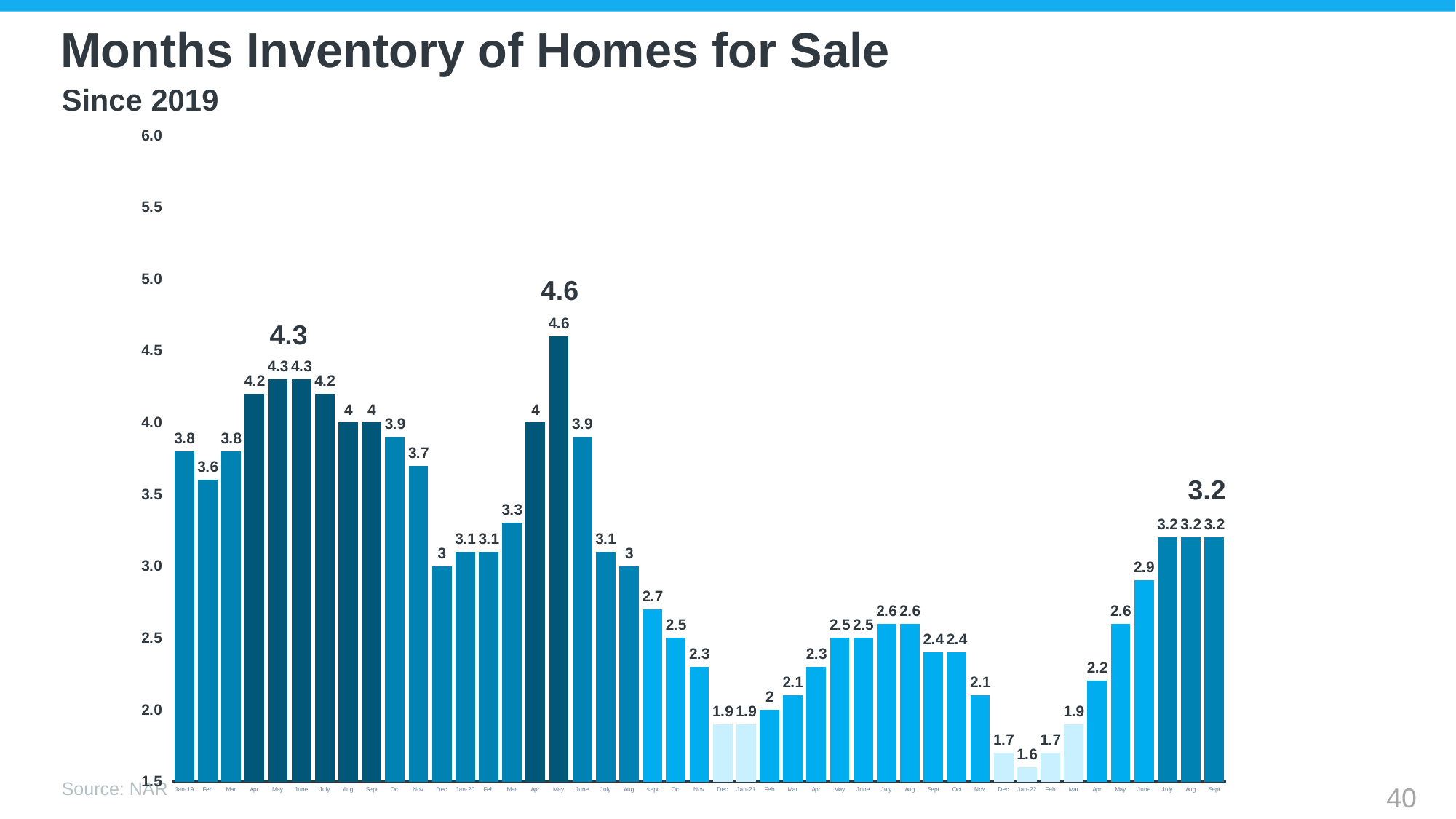
Which is larger, the value for Jan-19 or the value for Jan-20? Jan-19 What kind of chart is shown on the slide? bar chart Is the value for Jan-22 greater or less than 2.0? less How many monthly bars are plotted on the chart? 45 Which month has the highest months inventory value? May 2020 From Jan-22 to Sept 2022, do the values rise or fall? rise What is the months inventory value for Jan-19? 3.8 What is the difference between the Jan-19 value (3.8) and the final Sept 2022 value (3.2)? 0.6 Which month has the lowest months inventory value? Jan-22 What is the months inventory value for Jan-22? 1.6 What is the months inventory value for May 2020 (the tallest bar)? 4.6 What is the source cited for the chart data? NAR